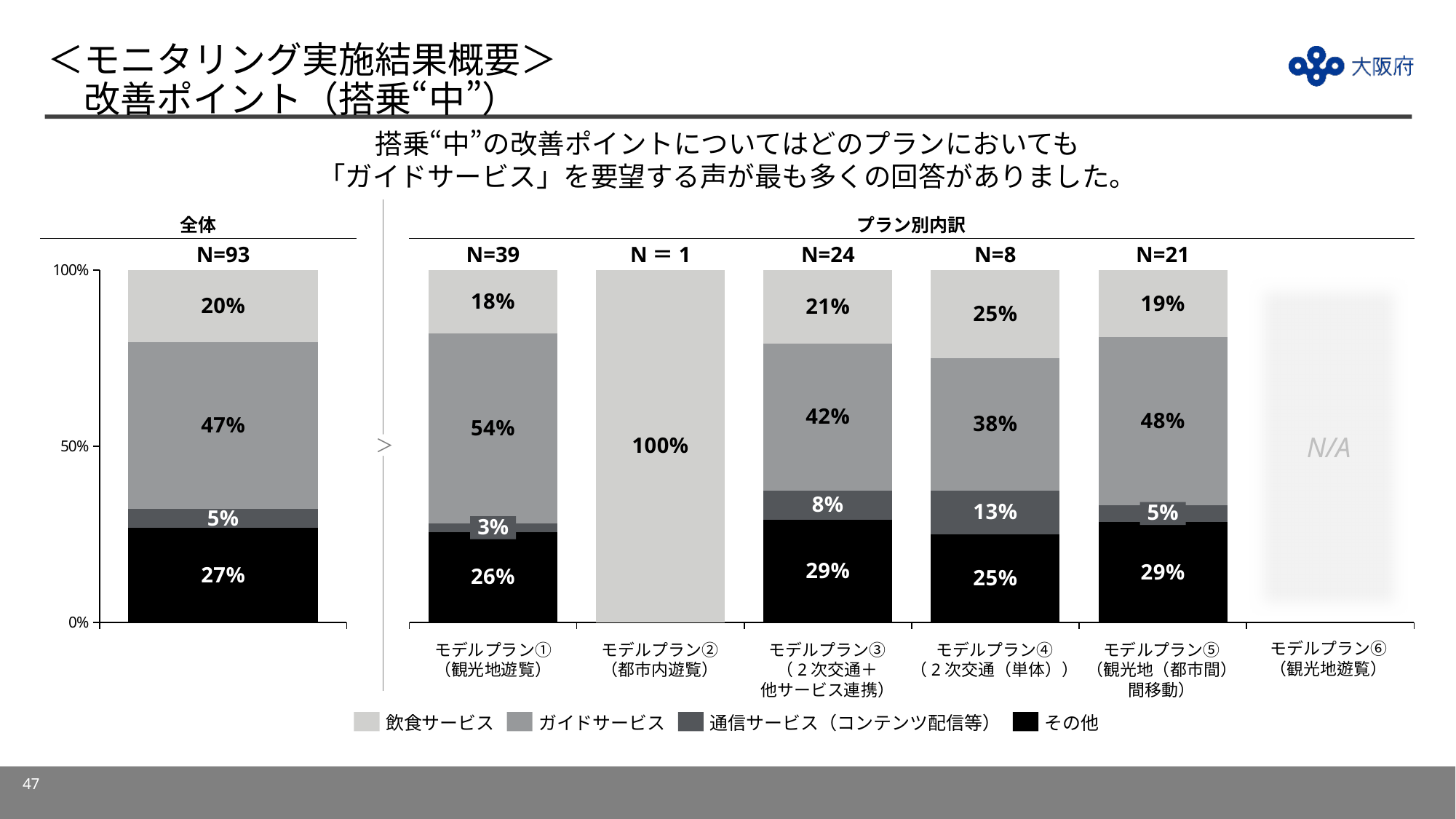
What kind of chart is used on this slide? Stacked bar chart In the プラン別内訳 chart, what percentage is shown for 通信サービス（コンテンツ配信等） in モデルプラン④? 13% In the 全体 chart, what is the N value shown above the bar? N=93 In the プラン別内訳 chart, what percentage is shown for ガイドサービス in モデルプラン①? 54% In the プラン別内訳 chart, what is the difference between the ガイドサービス percentages of モデルプラン① and モデルプラン④? 16% In the プラン別内訳 chart, which is larger: the その他 percentage for モデルプラン③ or for モデルプラン④? モデルプラン③ How many series does the legend list? 4 In the プラン別内訳 chart, what is shown for モデルプラン⑥? N/A In the 全体 chart, what percentage is shown for ガイドサービス? 47% In the プラン別内訳 chart, which model plan has the highest ガイドサービス percentage? モデルプラン① In the プラン別内訳 chart, what is the N value shown for モデルプラン③? N=24